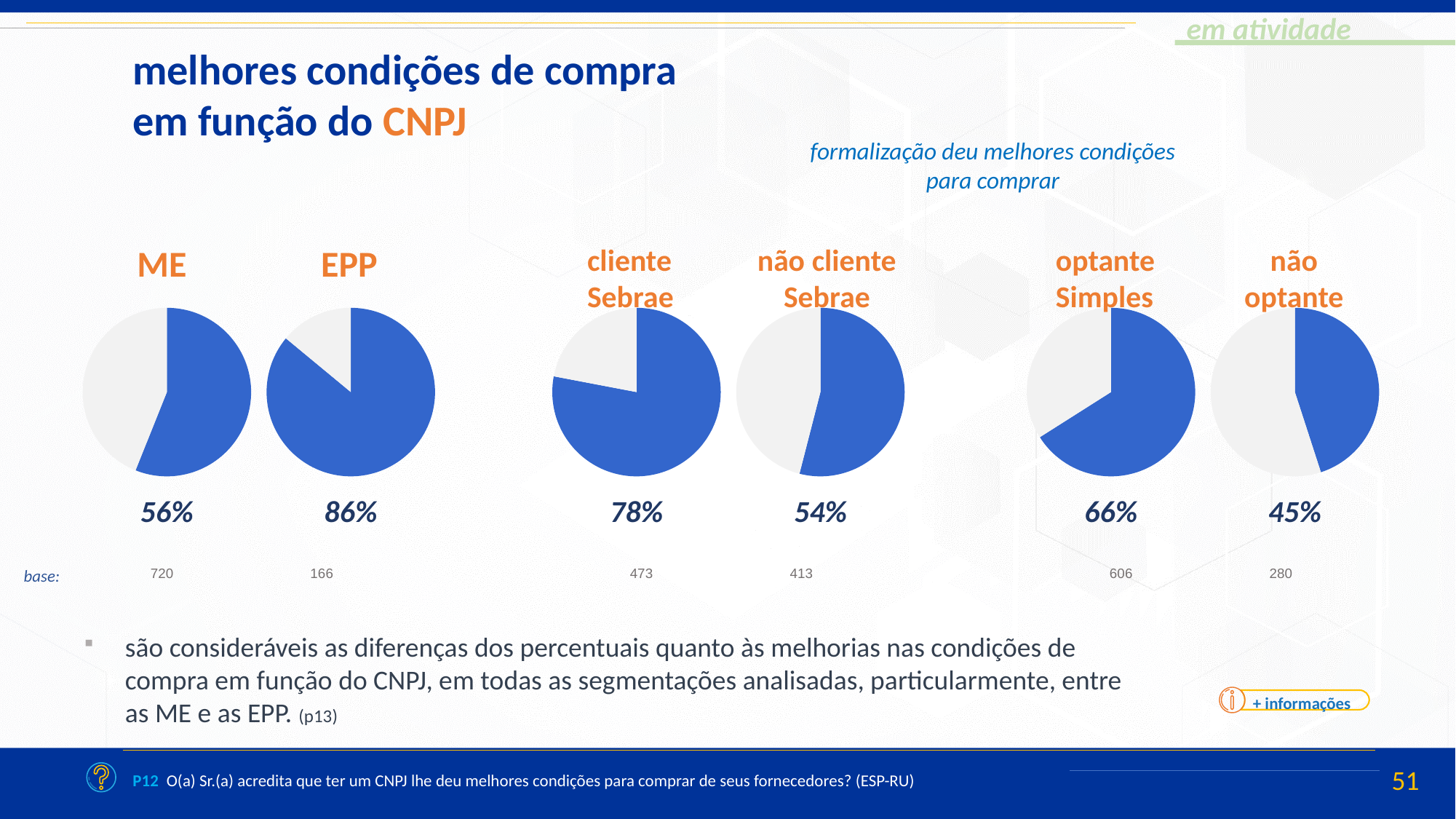
Across the six pie charts on the slide, which segment has the lowest percentage? não optante What is the difference in percentage points between the EPP pie chart and the ME pie chart? 30 percentage points In the não optante pie chart, what percentage is shown? 45% Which is larger: the percentage in the cliente Sebrae pie chart or the não cliente Sebrae pie chart? cliente Sebrae In the cliente Sebrae pie chart, what percentage is shown? 78% In the não cliente Sebrae pie chart, what percentage is shown? 54% In the EPP pie chart, what percentage is shown? 86% How many pie charts are shown on the slide? 6 Across the six pie charts on the slide, which segment has the highest percentage? EPP In the ME pie chart, what percentage is shown for the blue slice? 56% What type of chart is used to show the percentages on the slide? pie chart In the optante Simples pie chart, what percentage is shown? 66%